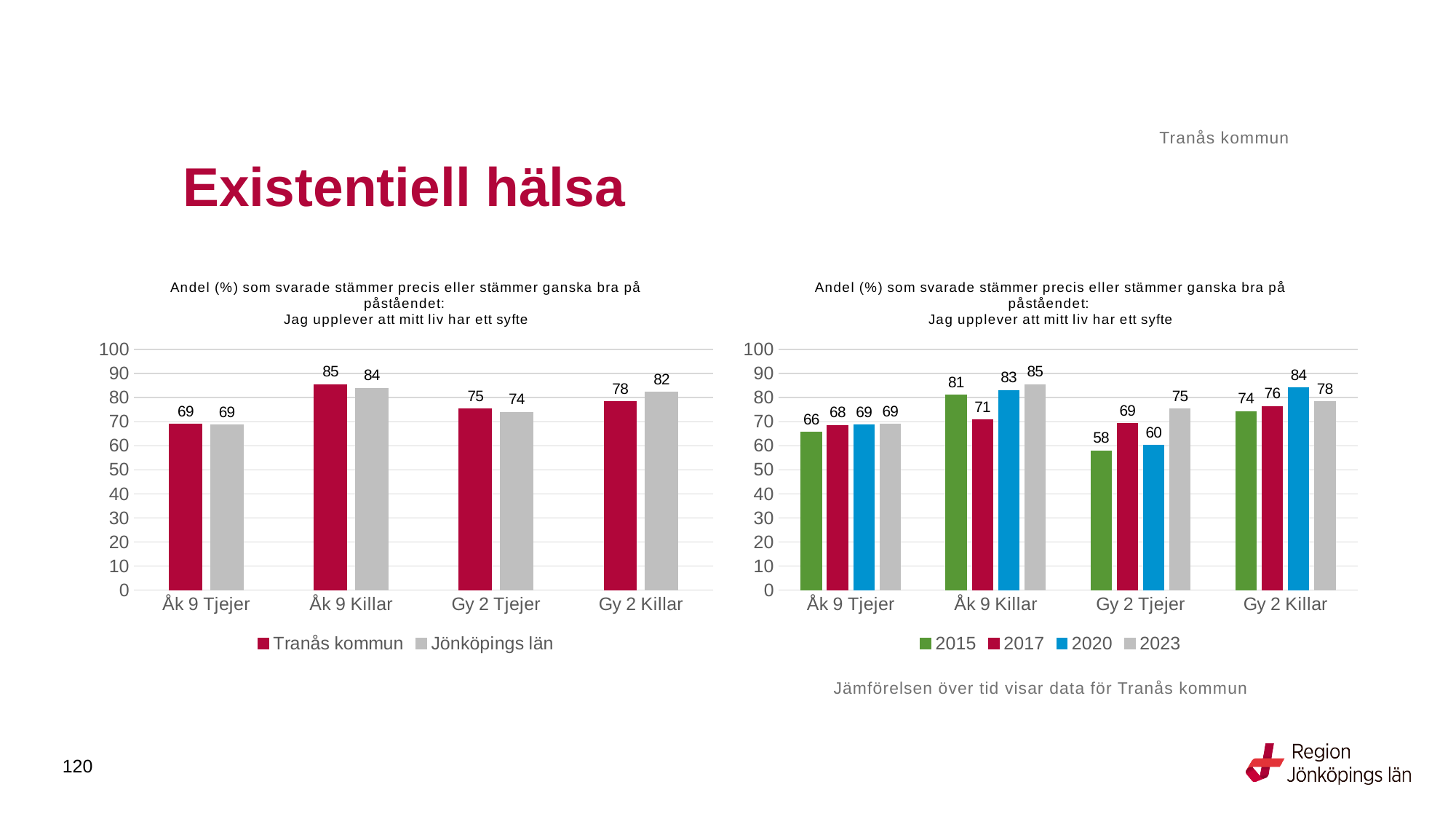
In the left chart, what is the difference between Tranås kommun and Jönköpings län for Gy 2 Killar? 4 In the right chart, what is the value for 2015 for Gy 2 Tjejer? 58 In the left chart, how many series does the legend list? 2 In the right chart, what is the difference between the 2023 and 2015 values for Gy 2 Tjejer? 17 In the left chart, what is the value for Jönköpings län for Gy 2 Killar? 82 In the right chart, is the 2023 value for Åk 9 Killar larger than the 2017 value for Åk 9 Killar? Yes In the left chart, which category has the highest value for Tranås kommun? Åk 9 Killar In the right chart, how many series does the legend list? 4 In the right chart, which category has the lowest value for 2020? Gy 2 Tjejer In the left chart, what is the value for Tranås kommun for Åk 9 Killar? 85 In the right chart, what is the value for 2020 for Gy 2 Killar? 84 What type of chart is the left chart? Bar chart